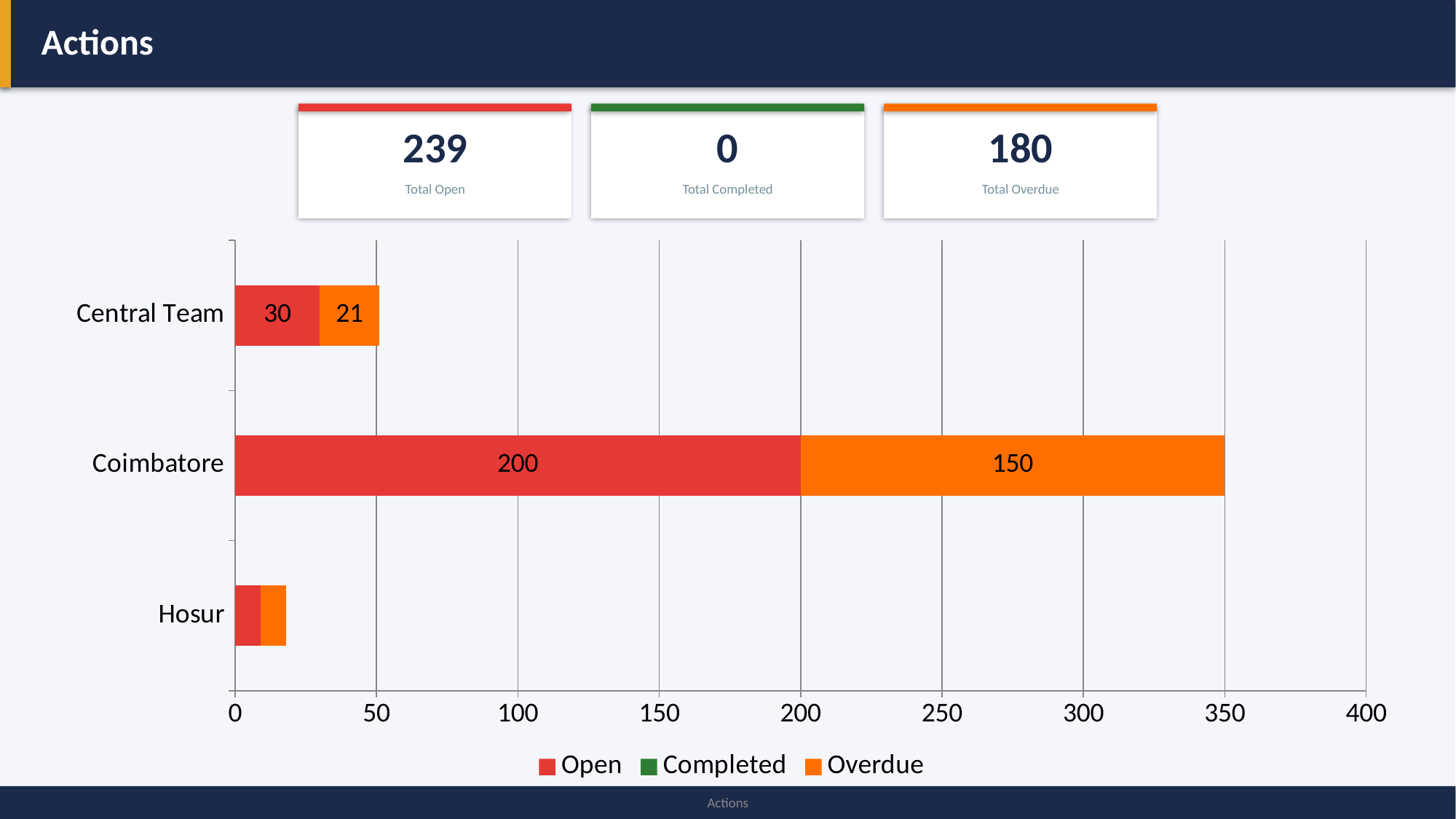
What type of chart is shown on the slide? stacked bar chart What is the difference between the Open and Overdue values for Coimbatore? 50 What is the Overdue value for Coimbatore? 150 How many categories are shown on the chart's vertical axis? 3 What is the total of the stacked bar for Coimbatore? 350 How many series does the chart legend list? 3 Which category has the shortest total bar? Hosur What is the Open value for Coimbatore? 200 Which category has the longest total bar? Coimbatore Is the total bar for Hosur greater or less than 50? less What is the Overdue value for Central Team? 21 What is the Open value for Central Team? 30